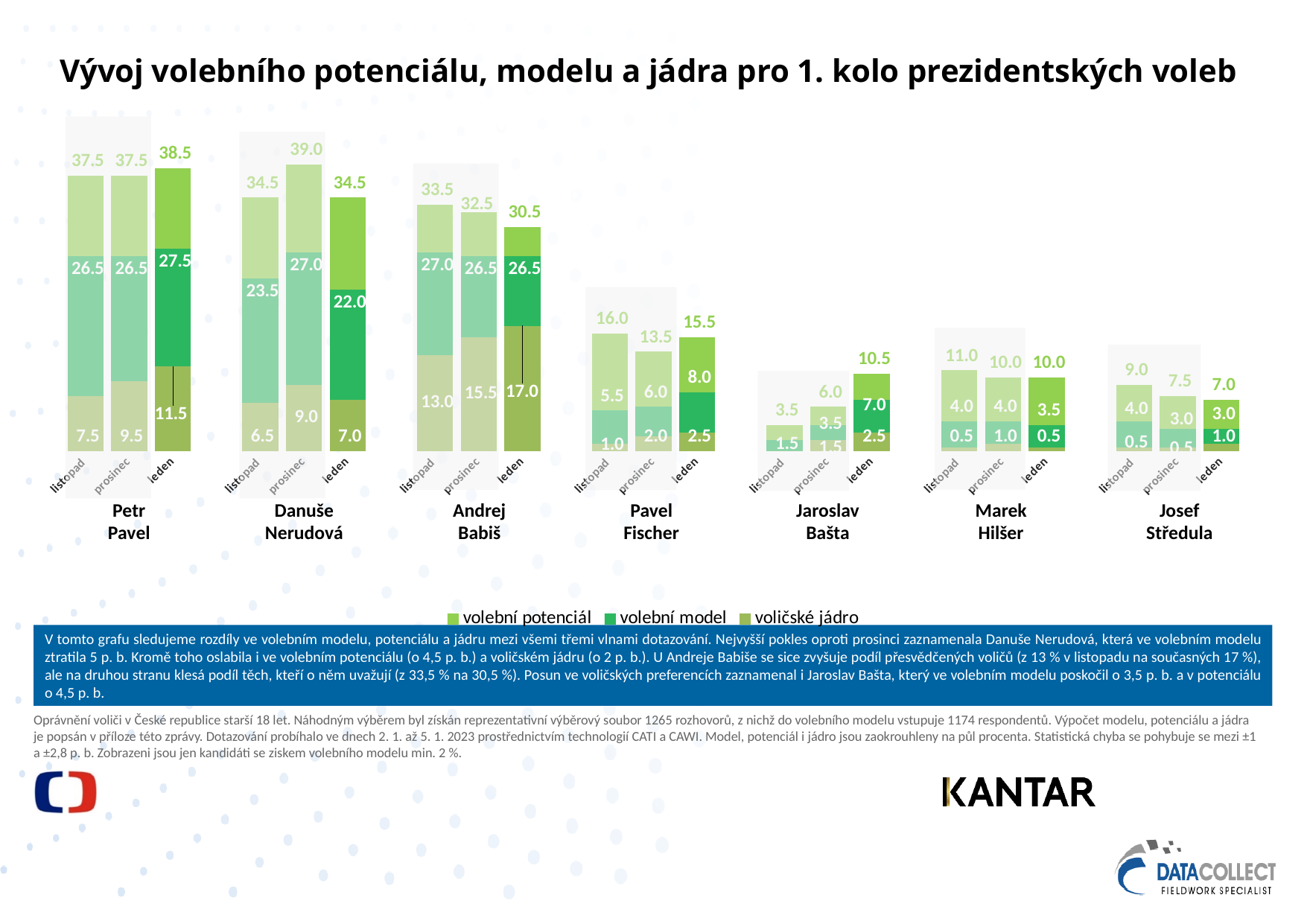
Does Jaroslav Bašta's volební potenciál rise or fall from listopad to leden? Rise What is the volební potenciál value for Petr Pavel in leden? 38.5 Which candidate has the highest volební potenciál in leden? Petr Pavel By how much did Danuše Nerudová's volební model fall from prosinec to leden? 5.0 What is the volební model value for Danuše Nerudová in prosinec? 27.0 Which candidate has the lowest volební potenciál in leden? Josef Středula What is the volební model value for Jaroslav Bašta in leden? 7.0 What is the voličské jádro value for Andrej Babiš in leden? 17.0 What kind of chart is shown on the slide? Bar chart How many candidates are shown in the chart? 7 How many series does the legend list? 3 Which is larger: Andrej Babiš's volební potenciál in listopad or Danuše Nerudová's volební potenciál in listopad? Danuše Nerudová's